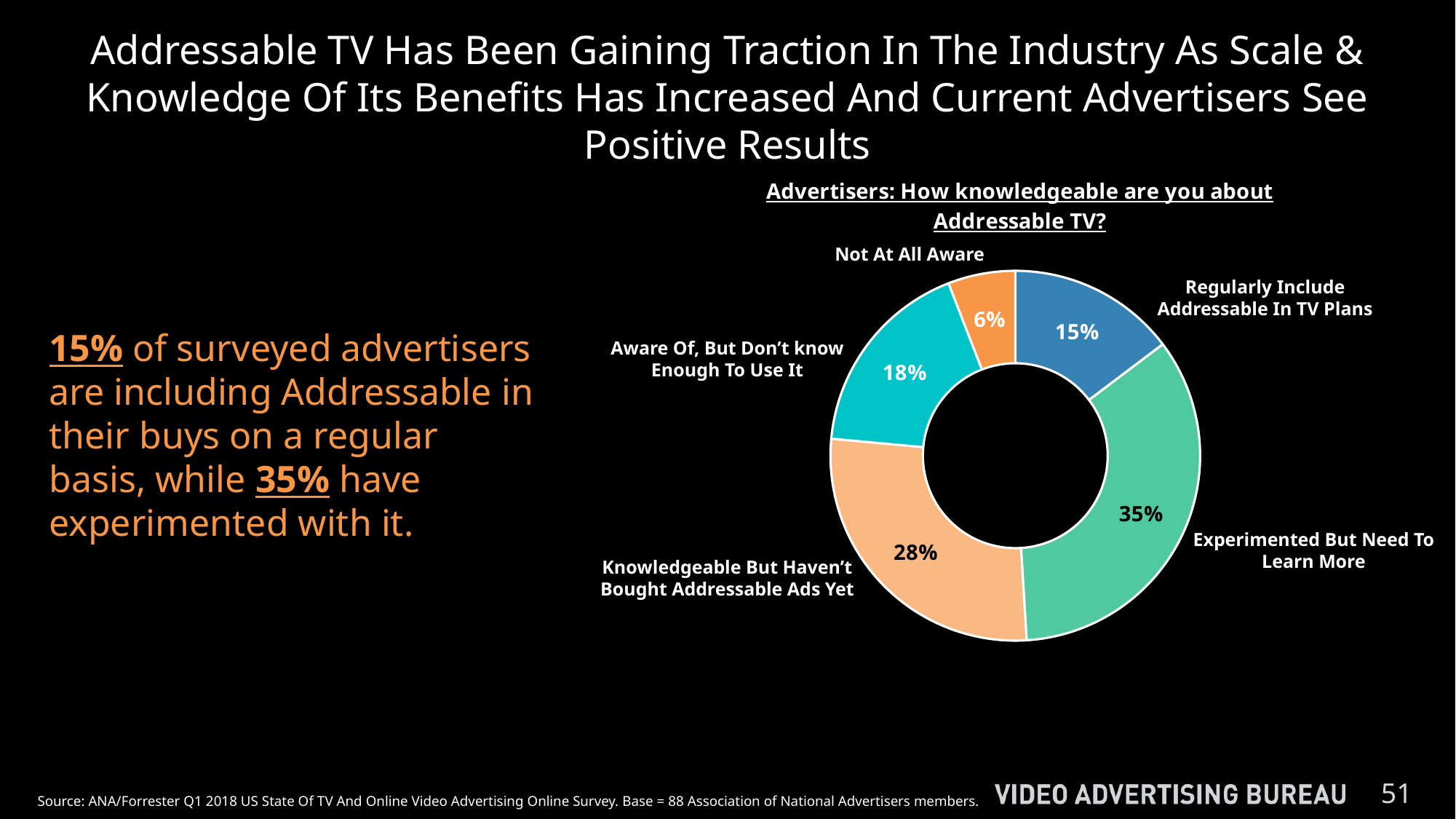
What percentage of advertisers are not at all aware of Addressable TV? 6% Which category has the smallest share of the chart? Not At All Aware What percentage of advertisers have experimented with Addressable TV but need to learn more? 35% How many categories are shown in the chart? 5 What is the title of the chart? Advertisers: How knowledgeable are you about Addressable TV? Which is larger: the share for 'Knowledgeable But Haven't Bought Addressable Ads Yet' or 'Aware Of, But Don't know Enough To Use It'? Knowledgeable But Haven't Bought Addressable Ads Yet What percentage of advertisers are aware of Addressable TV but don't know enough to use it? 18% What percentage of advertisers say they regularly include Addressable in TV plans? 15% What type of chart is shown on the slide? Doughnut (pie) chart What is the difference in percentage points between 'Experimented But Need To Learn More' and 'Regularly Include Addressable In TV Plans'? 20 percentage points What share of advertisers are knowledgeable but haven't bought Addressable ads yet? 28% Which category has the largest share of the chart? Experimented But Need To Learn More